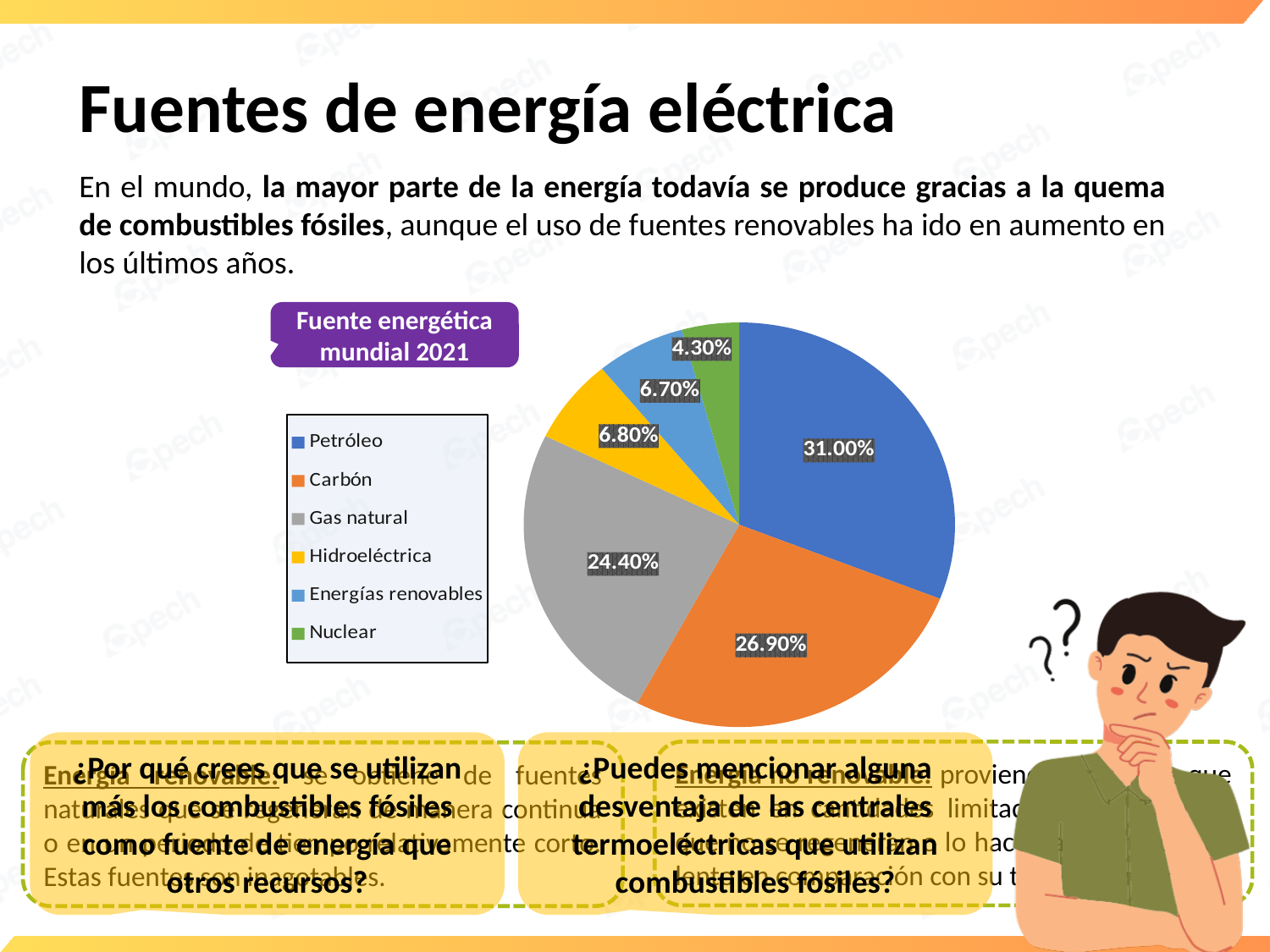
What is the difference between the shares of Petróleo and Carbón? 4.10% Which is larger, the share for Gas natural or the share for Hidroeléctrica? Gas natural What is the share for Gas natural in the pie chart? 24.40% Which energy source has the largest slice of the pie chart? Petróleo What is the share for Petróleo in the pie chart? 31.00% What is the difference between the shares of Hidroeléctrica and Energías renovables? 0.10% How many categories does the pie chart legend list? 6 What kind of chart is shown on the slide? pie chart What is the share for Nuclear in the pie chart? 4.30% What is the title shown in the purple box next to the pie chart? Fuente energética mundial 2021 What is the share for Carbón in the pie chart? 26.90% Which energy source has the smallest slice of the pie chart? Nuclear